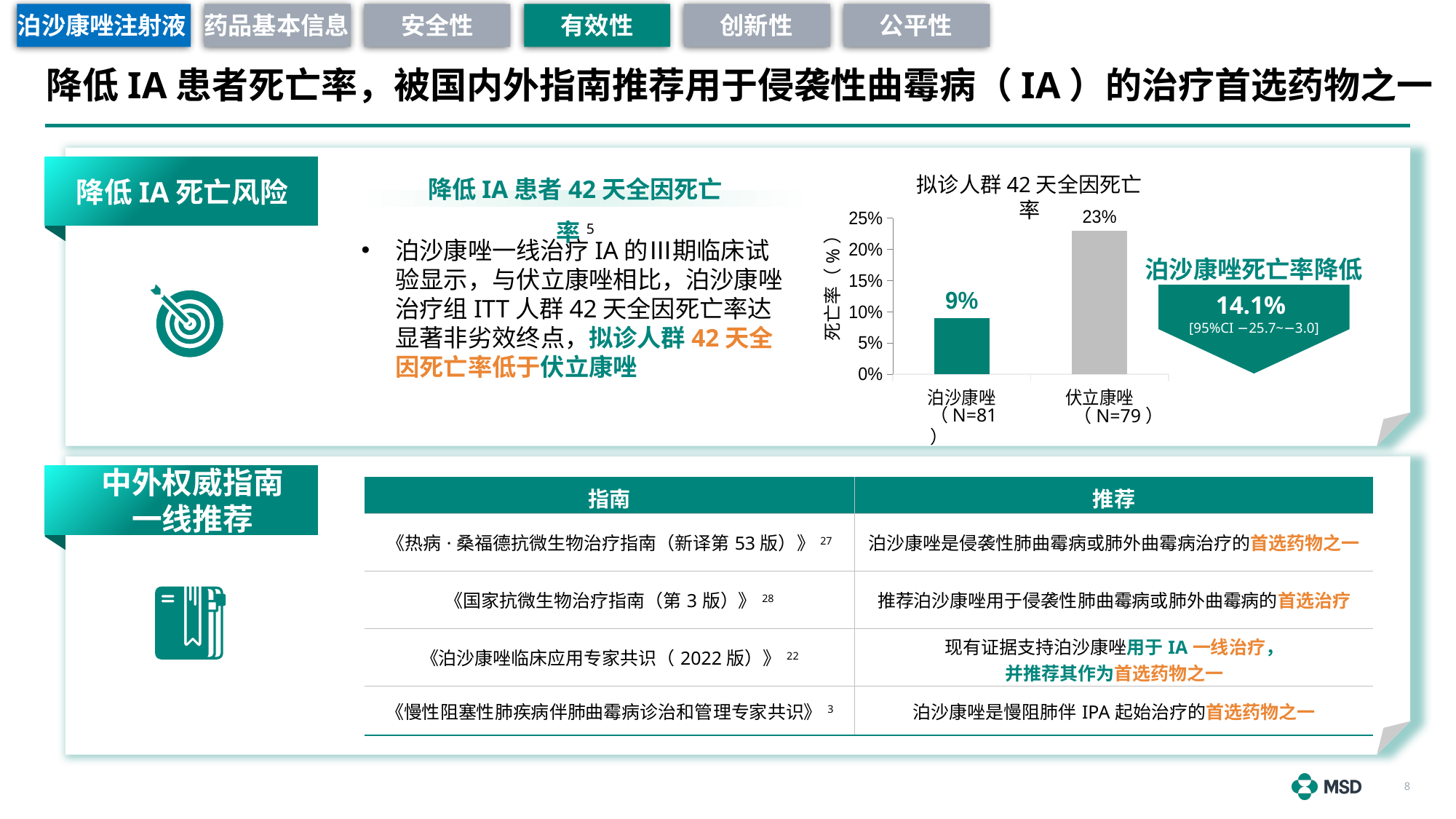
What is the title of the chart? 拟诊人群42天全因死亡率 What is the difference in mortality rate between 伏立康唑 and 泊沙康唑 in the chart? 14% What is the 42-day all-cause mortality rate shown for 伏立康唑 in the chart? 23% How many treatment groups (bars) are shown in the chart? 2 What is the 42-day all-cause mortality rate shown for 泊沙康唑 in the chart? 9% What type of chart is used to show the 42-day all-cause mortality rates? bar chart Which treatment group has the lower mortality rate in the chart? 泊沙康唑 Is the mortality rate for 泊沙康唑 greater or less than 10%? less What is the sample size (N) shown for the 泊沙康唑 group in the chart? N=81 Is the mortality rate for 伏立康唑 greater or less than 20%? greater What is the label of the y-axis of the chart? 死亡率（%） Which treatment group has the higher mortality rate in the chart? 伏立康唑